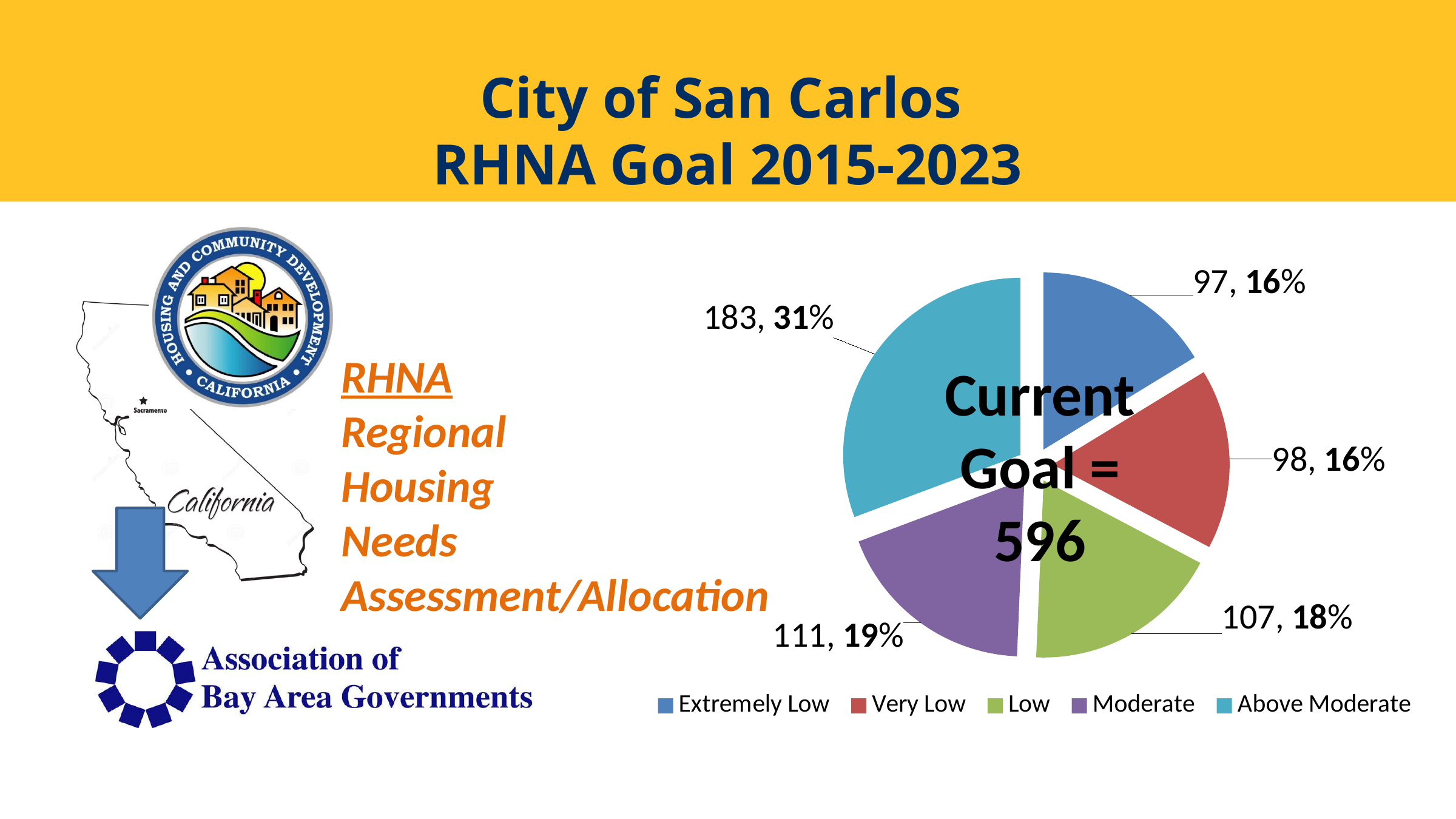
What is the value shown for the Extremely Low category? 97 How many units are allocated to the Above Moderate category? 183 What is the value shown for the Low category? 107 Which category has the largest slice of the pie? Above Moderate Which colour represents the Above Moderate category in the legend? teal (light blue) How many categories does the pie chart have? 5 What kind of chart is shown on the slide? pie chart What percentage of the pie does the Moderate slice represent? 19% Which is larger, the value for Low or the value for Very Low? Low What total is printed in the centre of the pie chart? Current Goal = 596 What is the difference between the Above Moderate value and the Moderate value? 72 What percentage share is shown for the Very Low category? 16%